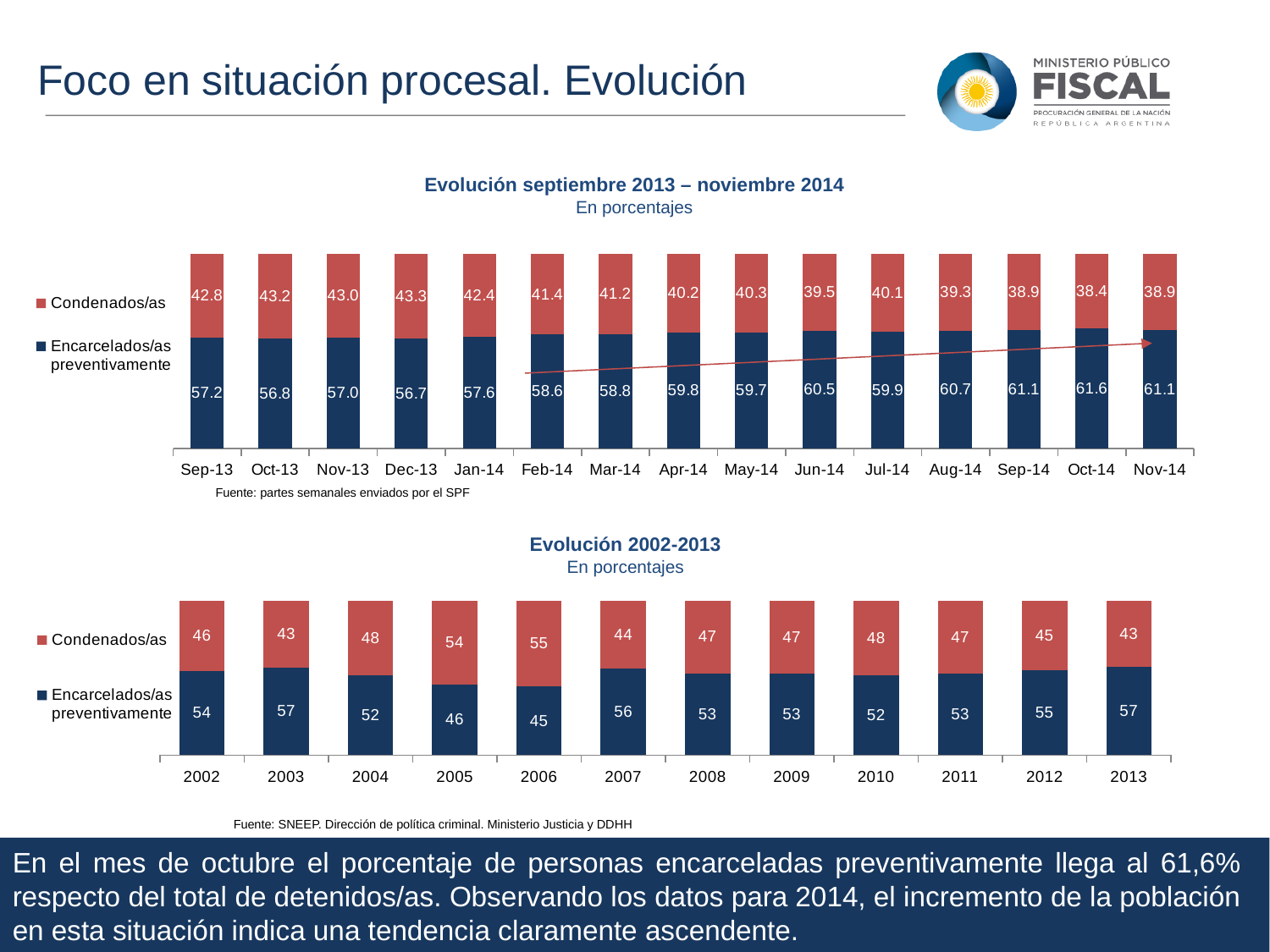
In the 'Evolución septiembre 2013 – noviembre 2014' chart, does the Encarcelados/as preventivamente series generally rise or fall from Sep-13 to Nov-14? rise In the 'Evolución septiembre 2013 – noviembre 2014' chart, what is the difference between the Encarcelados/as preventivamente values for Nov-14 and Sep-13? 3.9 In the 'Evolución septiembre 2013 – noviembre 2014' chart, which month has the lowest value for Condenados/as? Oct-14 In the 'Evolución septiembre 2013 – noviembre 2014' chart, which month has the highest value for Encarcelados/as preventivamente? Oct-14 In the 'Evolución 2002-2013' chart, how many series does the legend list? 2 In the 'Evolución septiembre 2013 – noviembre 2014' chart, what is the value for Encarcelados/as preventivamente in Oct-14? 61.6 In the 'Evolución 2002-2013' chart, what is the value for Condenados/as in 2006? 55 In the 'Evolución 2002-2013' chart, is the Encarcelados/as preventivamente value larger in 2003 or in 2005? 2003 What kind of chart is the 'Evolución 2002-2013' chart? stacked bar chart In the 'Evolución septiembre 2013 – noviembre 2014' chart, what is the value for Condenados/as in Sep-13? 42.8 In the 'Evolución 2002-2013' chart, which year has the lowest value for Encarcelados/as preventivamente? 2006 In the 'Evolución septiembre 2013 – noviembre 2014' chart, how many months are shown on the x axis? 15